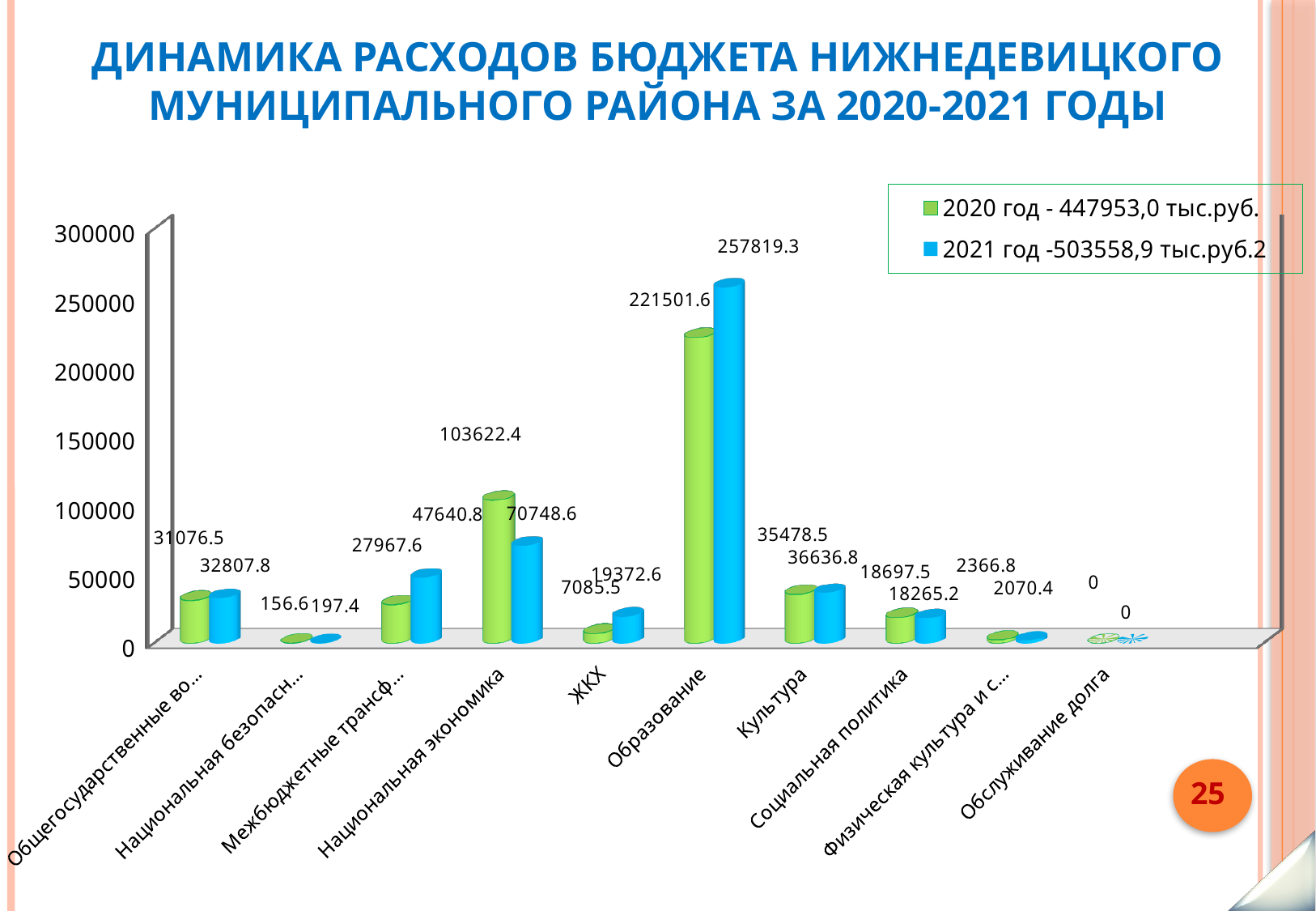
What is the difference between the 2020 and 2021 values for Национальная экономика? 32873.8 By how much did the value for Образование increase from 2020 to 2021? 36317.7 How many categories are shown on the x axis? 10 How many series does the legend list? 2 Which category has the highest 2021 value? Образование For Национальная экономика, which year has the larger value, 2020 or 2021? 2020 Which category has the lowest 2020 value? Обслуживание долга What is the 2021 value for Культура? 36636.8 What kind of chart is shown on the slide? bar chart What is the 2021 value for ЖКХ? 19372.6 Is the 2020 value for Национальная экономика greater or less than 100000? greater What is the 2020 value for Образование? 221501.6